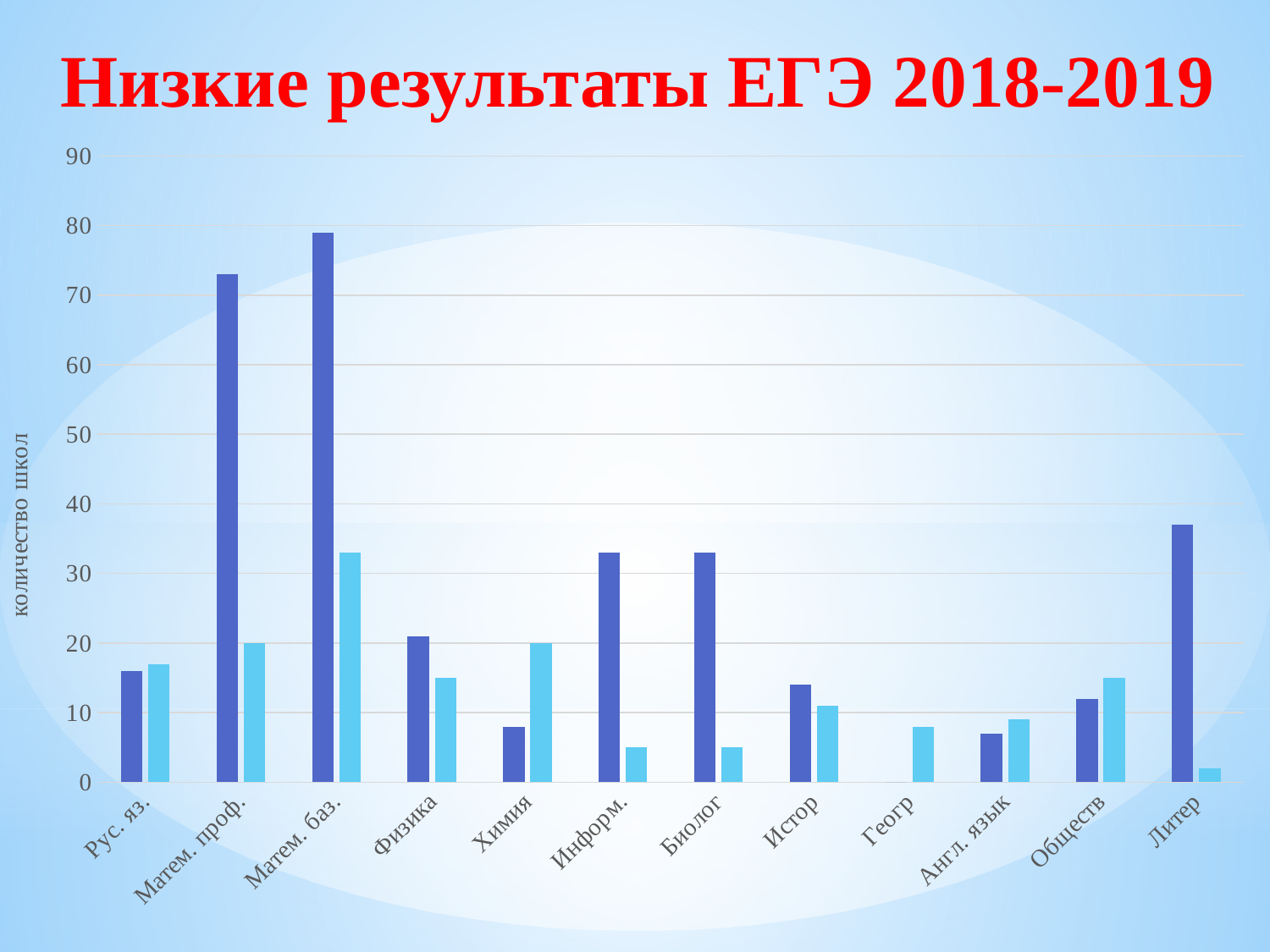
Which category has the shortest light blue bar? Литер What is the label on the vertical axis? количество школ How many subject categories are shown on the x axis? 12 Which category has the tallest dark blue bar? Матем. баз. What kind of chart is shown on the slide? bar chart Is the dark blue bar for Литер greater or less than 30? greater Is the dark blue bar for Матем. баз. greater or less than 70? greater Which category has the tallest light blue bar? Матем. баз. Which is larger, the light blue bar for Химия or the light blue bar for Физика? Химия Is the light blue bar for Биолог greater or less than 10? less Which is larger, the dark blue bar for Матем. проф. or the dark blue bar for Физика? Матем. проф. What is the title of the chart? Низкие результаты ЕГЭ 2018-2019